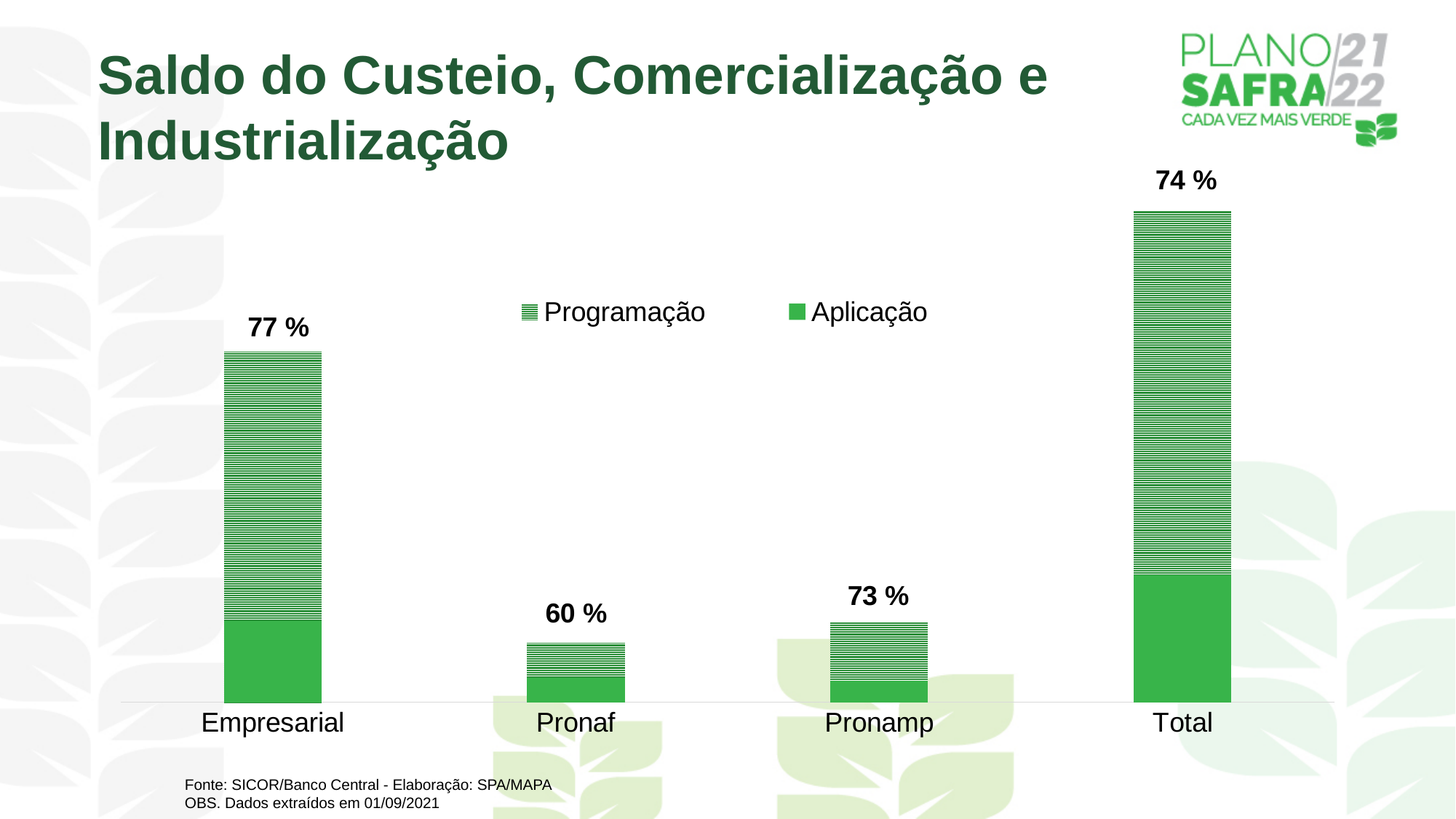
Which has the larger percentage label, Pronamp or Total? Total Which category has the tallest bar on the chart? Total Which category has the lowest percentage label? Pronaf What percentage label is shown above the Empresarial bar? 77 % What percentage label is shown above the Pronaf bar? 60 % What percentage label is shown above the Total bar? 74 % Which category has the highest percentage label? Empresarial How many series does the legend list? 2 How many categories are shown on the x axis? 4 What is the difference in percentage points between the labels for Empresarial and Pronaf? 17 What percentage label is shown above the Pronamp bar? 73 % What type of chart is shown on the slide? Bar chart